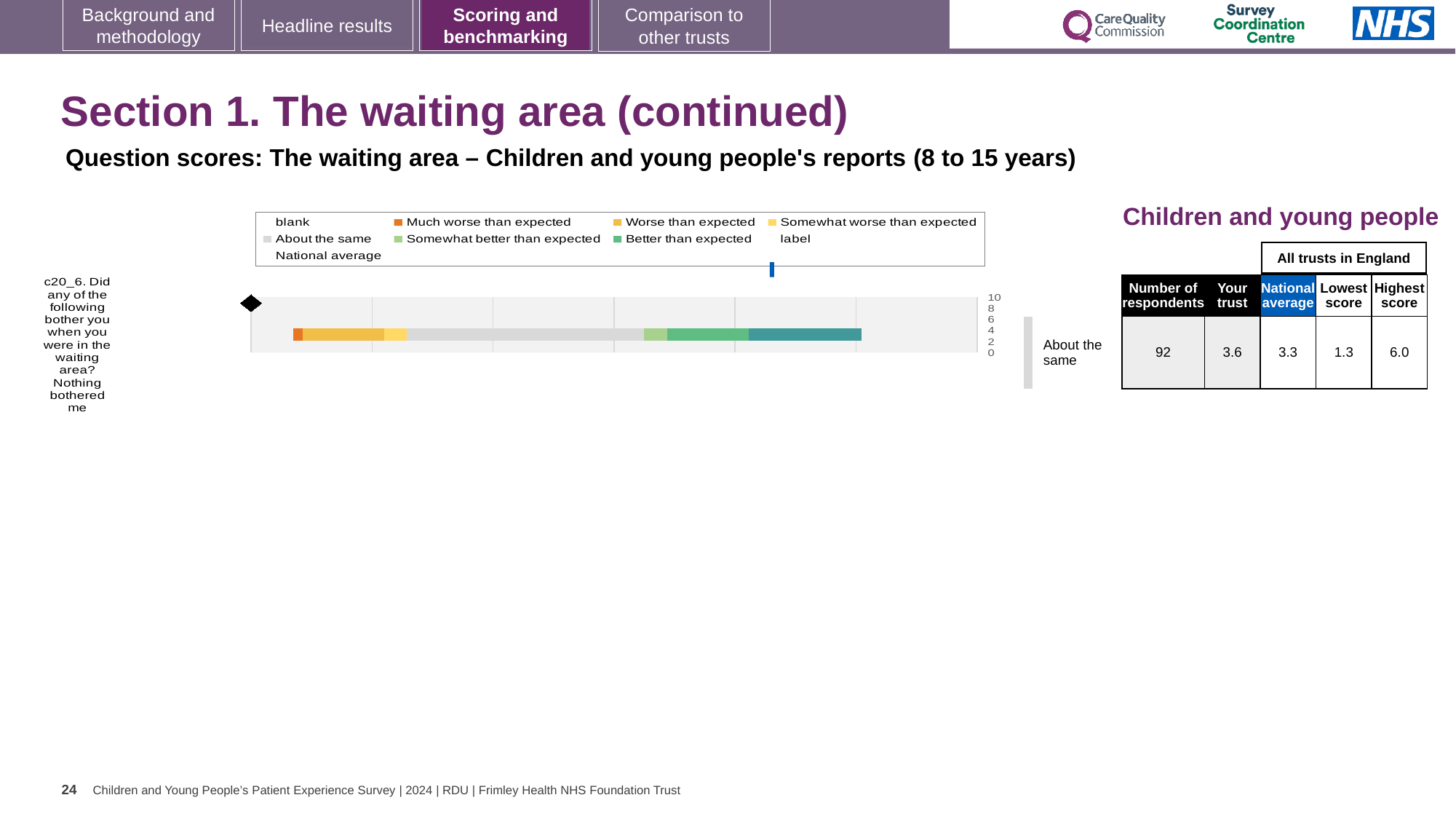
What benchmark category label is shown to the right of the bar for question c20_6? About the same What is the difference between the highest score and the lowest score for question c20_6? 4.7 How many respondents are reported for question c20_6? 92 What is the lowest score across all trusts in England for question c20_6? 1.3 Which question is plotted in the chart? c20_6. Did any of the following bother you when you were in the waiting area? Nothing bothered me What kind of chart is shown on the slide? bar chart What is the highest value shown on the chart's axis? 10 How many questions (categories) are plotted in the chart? 1 What is the national average score for question c20_6 shown in the table next to the chart? 3.3 What is the highest score across all trusts in England for question c20_6? 6.0 What is the 'Your trust' score for question c20_6 shown in the table next to the chart? 3.6 Which is larger for question c20_6: the 'Your trust' score or the national average? Your trust